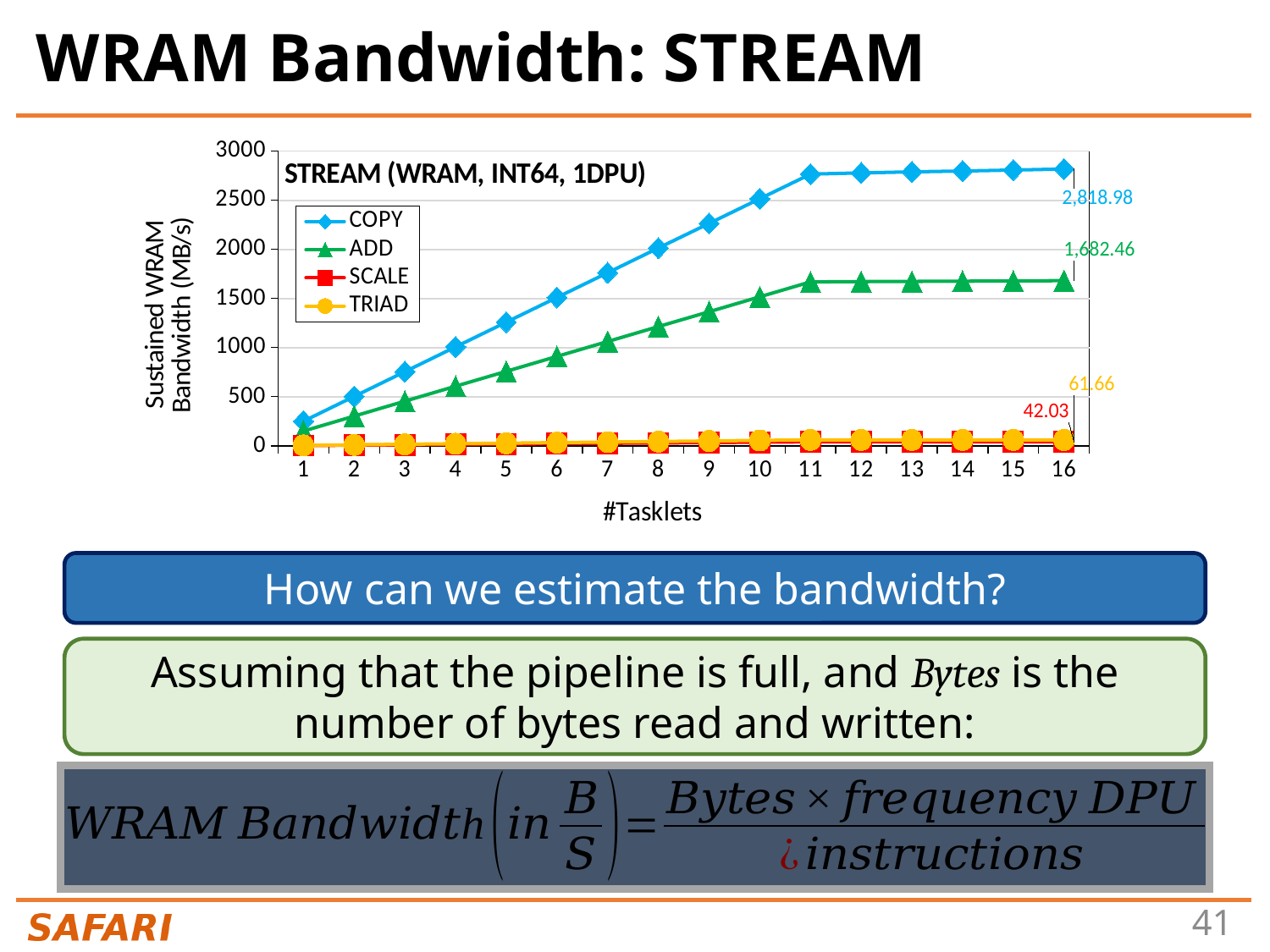
Is the COPY bandwidth at 8 tasklets greater or less than 1500? greater Which series has the lowest bandwidth at 16 tasklets? SCALE How many series does the chart legend list? 4 What is the sustained WRAM bandwidth for TRIAD at 16 tasklets? 61.66 What is the sustained WRAM bandwidth for SCALE at 16 tasklets? 42.03 What is the difference between the COPY and ADD bandwidth values at 16 tasklets? 1,136.52 What is the sustained WRAM bandwidth for COPY at 16 tasklets? 2,818.98 What kind of chart is shown on the slide? line chart What is the sustained WRAM bandwidth for ADD at 16 tasklets? 1,682.46 Which series has the highest bandwidth at 16 tasklets? COPY Does the COPY bandwidth rise or fall as the number of tasklets increases from 1 to 10? rise How many tasklet counts are plotted along the x axis? 16